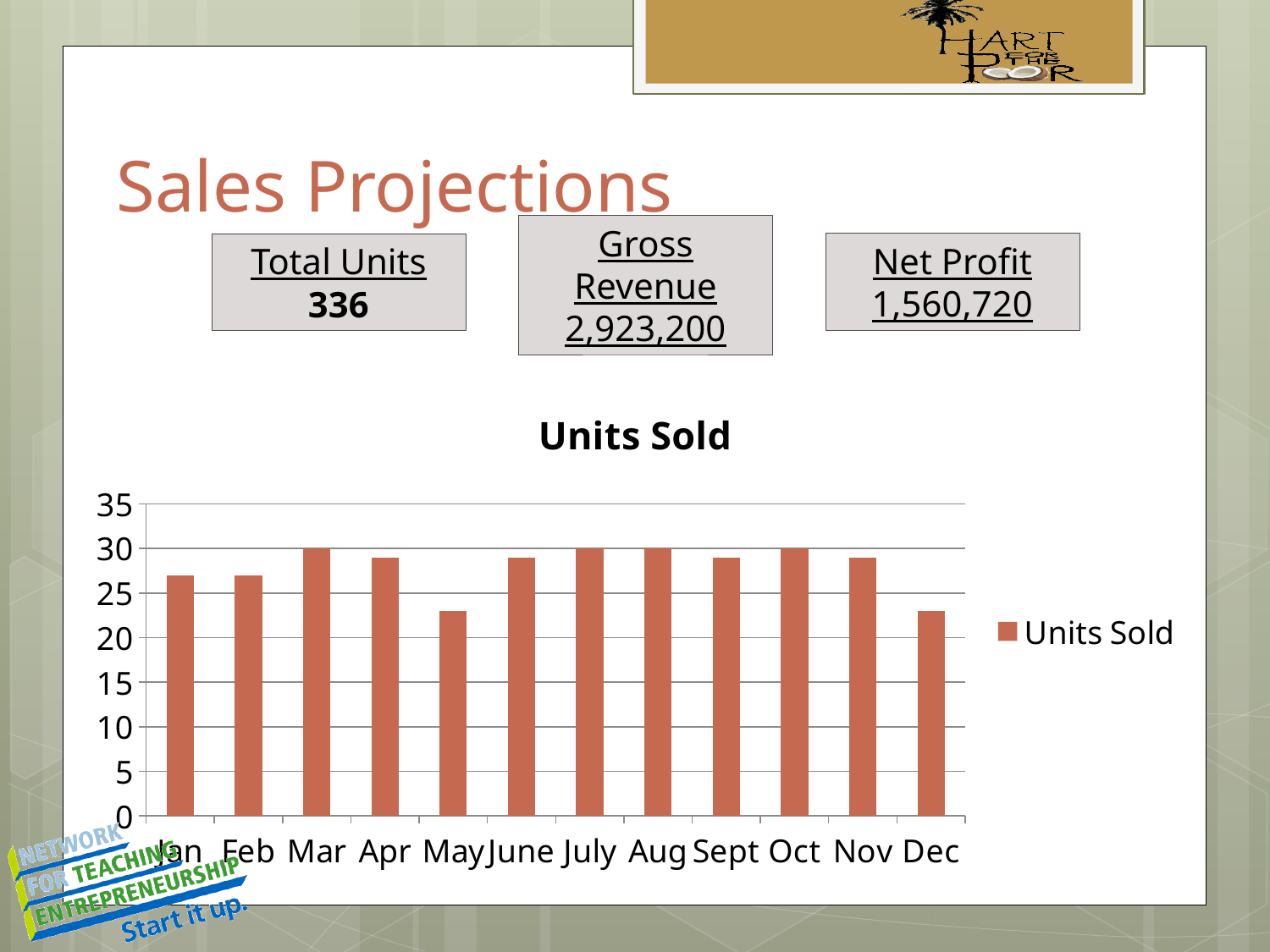
Which is larger in the Units Sold chart, Mar or May? Mar How many series does the legend of the Units Sold chart list? 1 What is the value for Mar in the Units Sold chart? 30 What is the title of the chart? Units Sold Is the value for May greater or less than 25? less What type of chart is shown on the slide? bar chart Is the value for Jan greater or less than 25? greater What is the value for July in the Units Sold chart? 30 Which is larger in the Units Sold chart, Dec or Aug? Aug What is the value for Oct in the Units Sold chart? 30 How many months are shown on the x axis of the Units Sold chart? 12 Is the value for Dec greater or less than 25? less